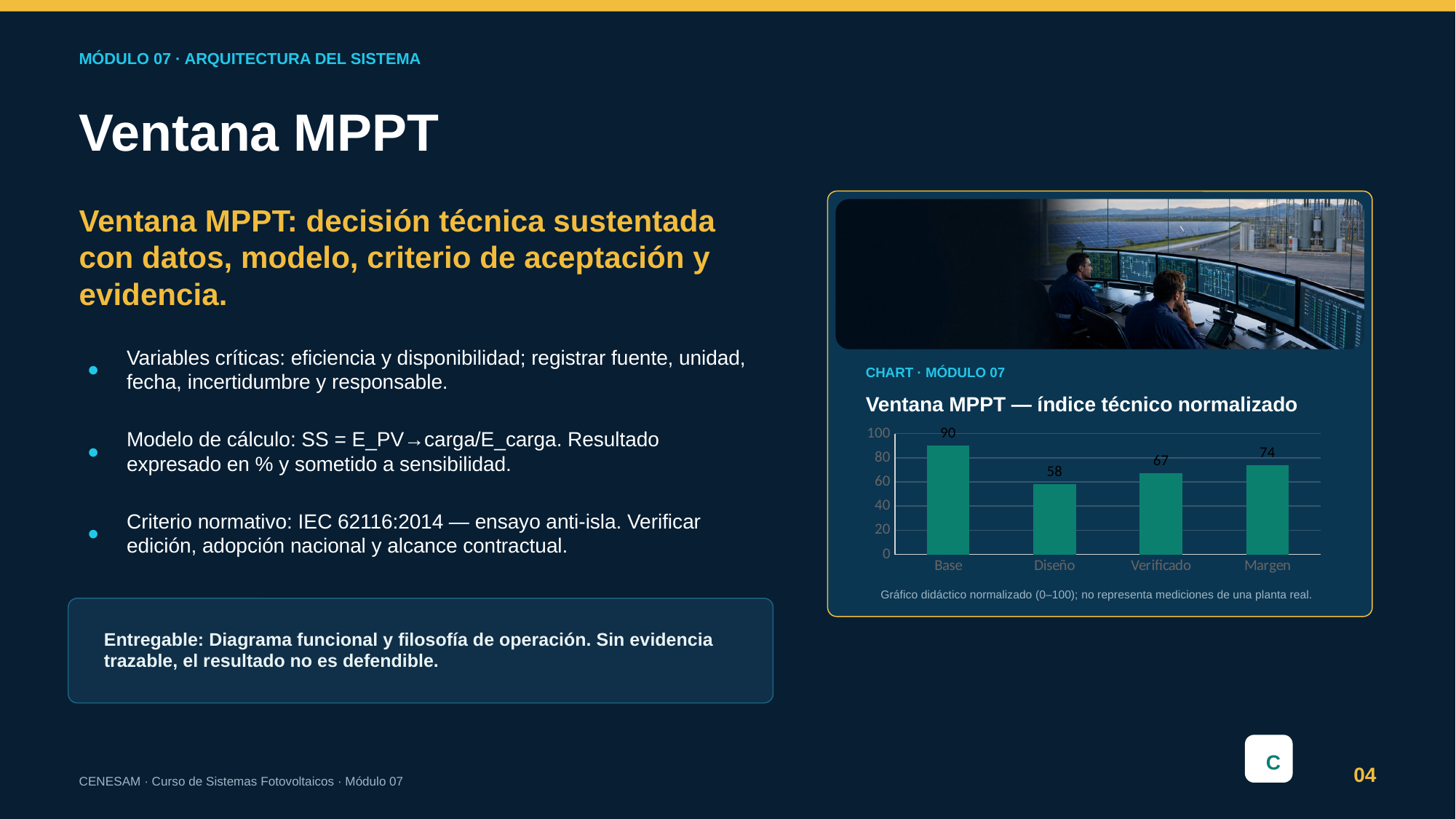
What is the difference between the values for Base and Diseño? 32 Which is larger, the value for Verificado or the value for Margen? Margen How many categories are shown on the x axis? 4 What is the value for Diseño? 58 Is the value for Diseño greater or less than 60? less What is the title of the chart? Ventana MPPT — índice técnico normalizado What is the value for Base? 90 Which category has the lowest value? Diseño Which category has the highest value? Base What is the value for Margen? 74 What kind of chart is shown? Bar chart What is the value for Verificado? 67